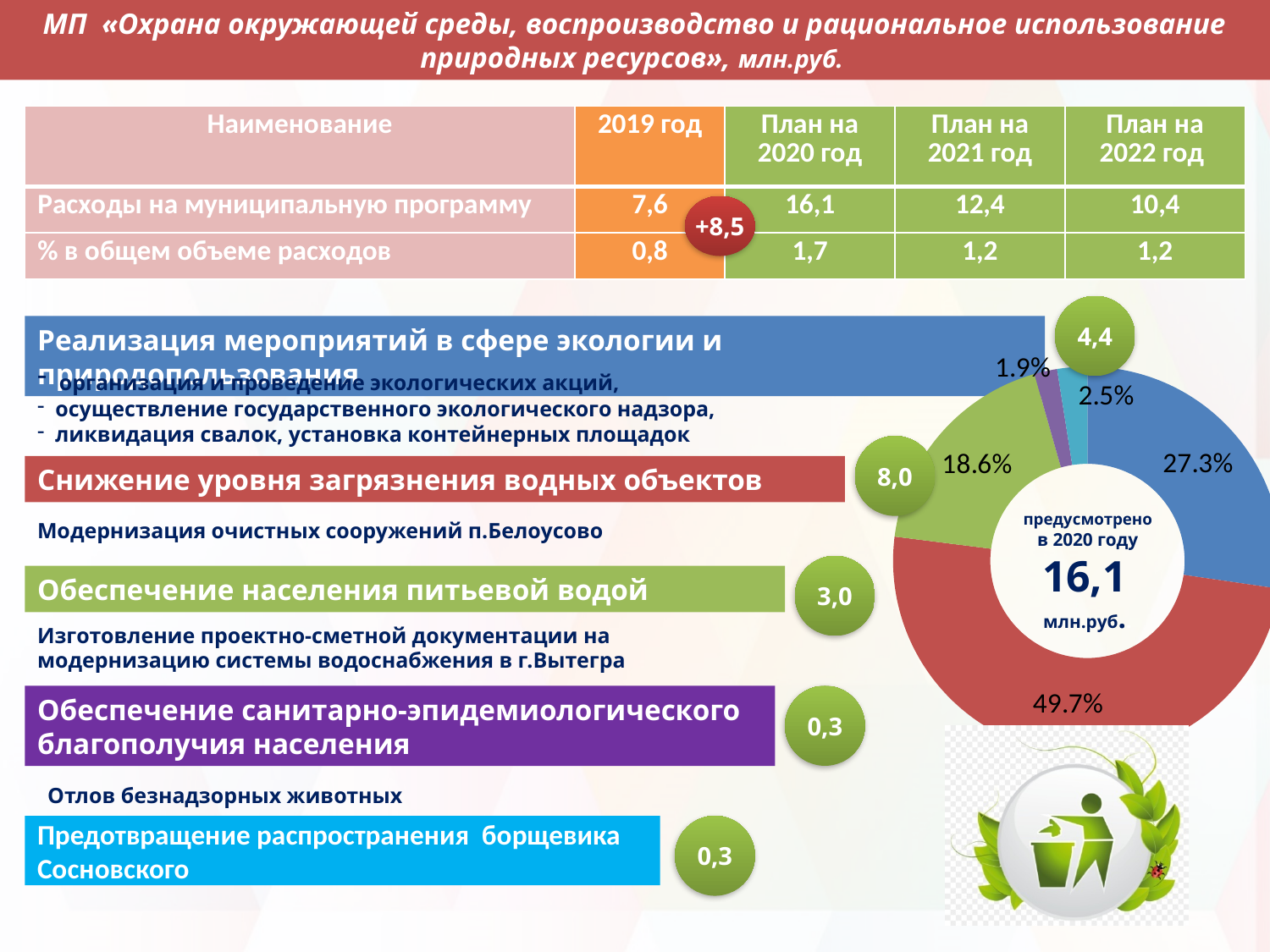
Is the red slice of the doughnut chart greater or less than 50%? less What percentage is shown for the red slice of the doughnut chart? 49.7% What is the largest slice of the doughnut chart? 49.7% What is the difference between the 2.5% slice and the 1.9% slice of the doughnut chart? 0.6% What is the smallest slice of the doughnut chart? 1.9% What kind of chart is shown on the right side of the slide? Doughnut (pie) chart What percentage is shown for the green slice of the doughnut chart? 18.6% How many slices does the doughnut chart have? 5 Which slice is larger in the doughnut chart, the green one (18.6%) or the blue one (27.3%)? The blue one (27.3%) What total amount is shown in the centre of the doughnut chart as planned for 2020? 16,1 млн.руб. What is the difference between the red slice (49.7%) and the blue slice (27.3%) of the doughnut chart? 22.4% What percentage is shown for the blue slice of the doughnut chart? 27.3%